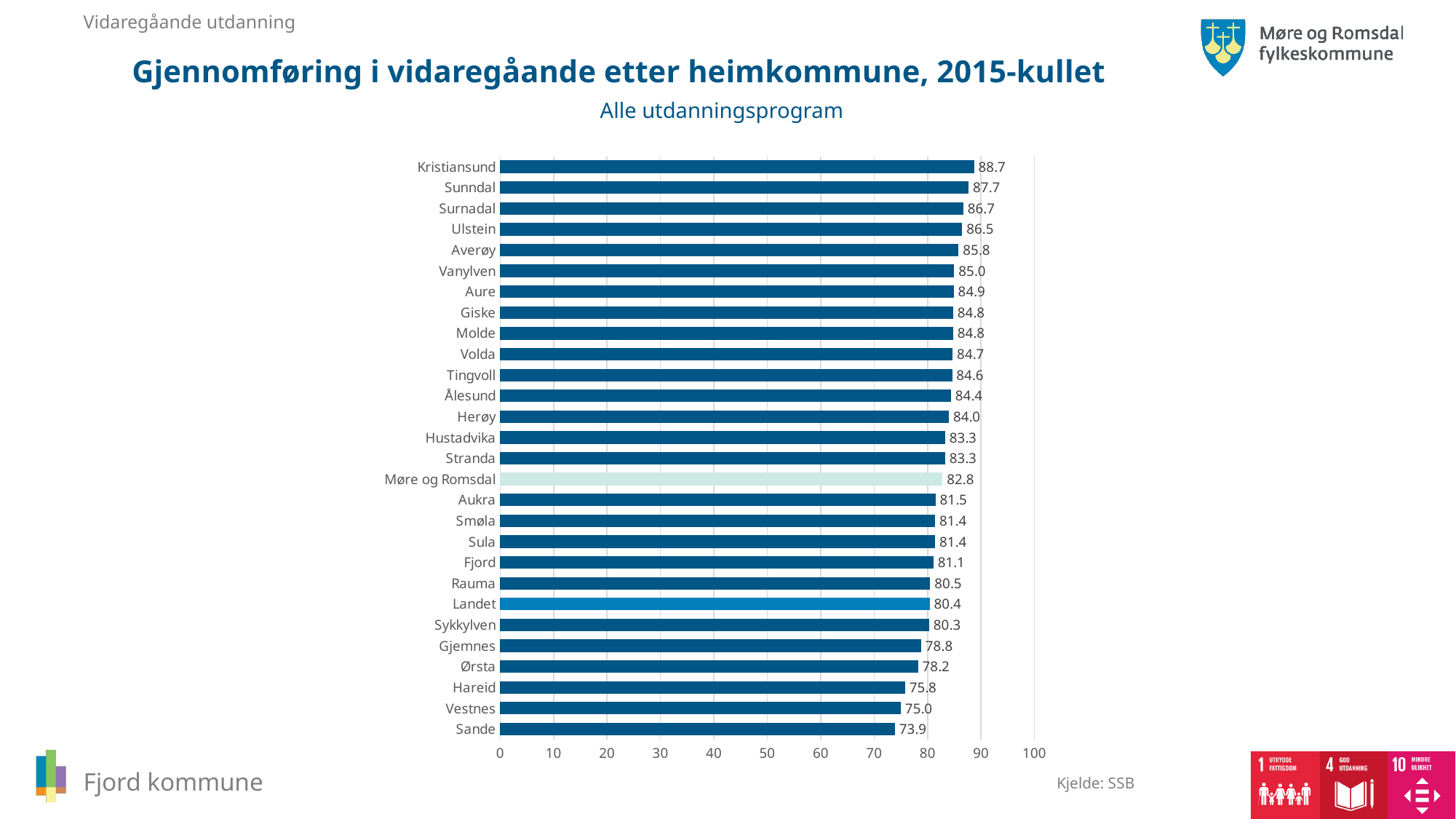
What is the value for Landet? 80.4 What is the difference between the values for Fjord and Landet? 0.7 Which is larger, the value for Ulstein or the value for Hareid? Ulstein What is the value for Fjord? 81.1 What is the value for Møre og Romsdal? 82.8 Which category has the lowest value? Sande How many categories are shown in the chart? 28 What is the difference between the values for Kristiansund and Sande? 14.8 Which category has the highest value? Kristiansund What kind of chart is shown on the slide? bar chart Is the value for Vestnes greater or less than 80? less What is the subtitle shown above the chart? Alle utdanningsprogram